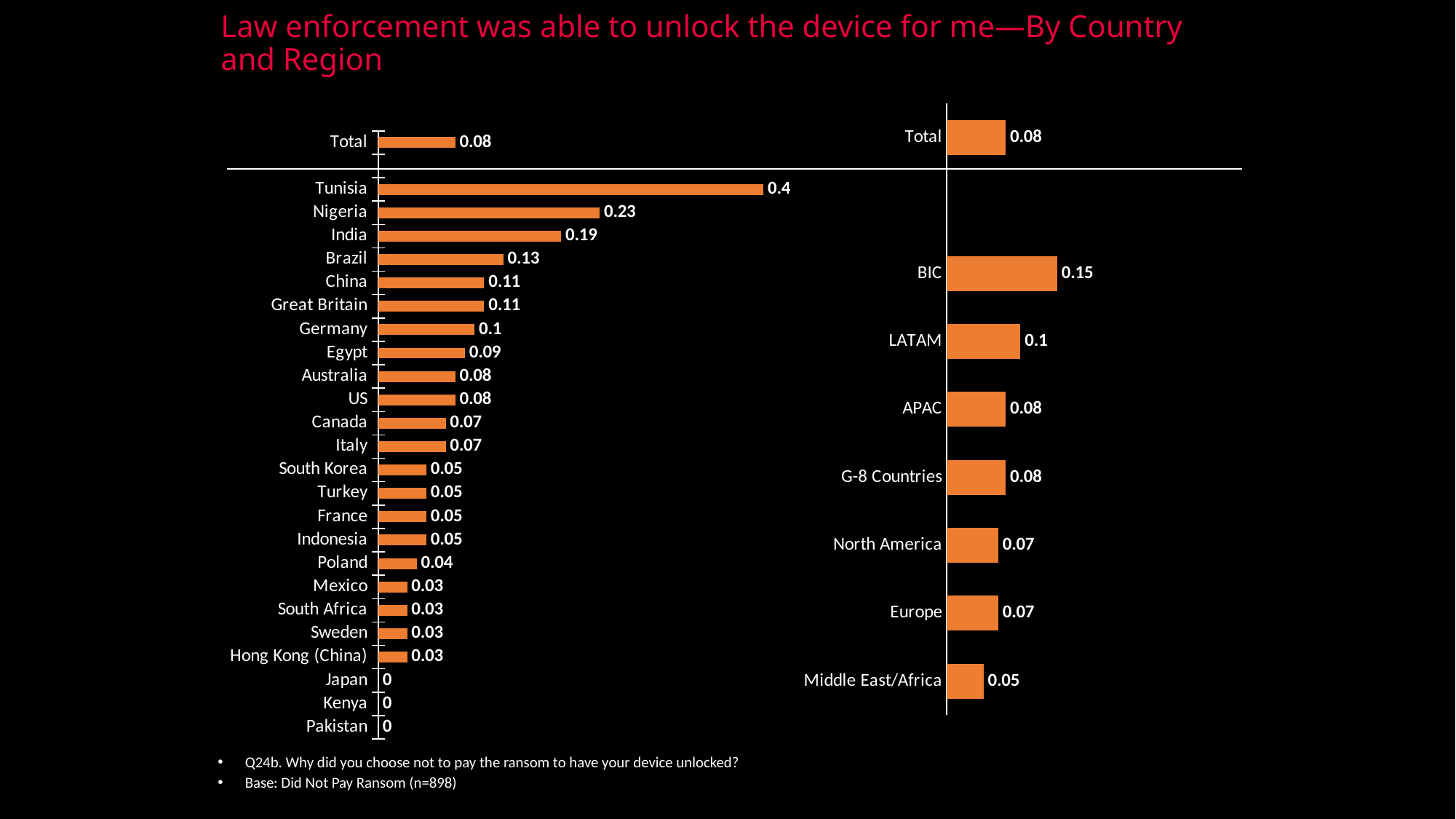
What type of chart is used on this slide? Bar chart In the left chart (by country), which is larger, the value for India or the value for Brazil? India In the right chart (by region), which region has the lowest value? Middle East/Africa In the left chart (by country), what is the value for Nigeria? 0.23 In the left chart (by country), what is the value for Tunisia? 0.4 In the left chart (by country), how many countries have a value of 0? 3 In the right chart (by region), what is the difference between the values for BIC and LATAM? 0.05 In the left chart (by country), which country has the highest value? Tunisia In the right chart (by region), what is the value for BIC? 0.15 In the right chart (by region), what is the value for Middle East/Africa? 0.05 In the right chart (by region), how many regions are shown below the Total bar? 7 In the left chart (by country), what is the difference between the values for Tunisia and Nigeria? 0.17